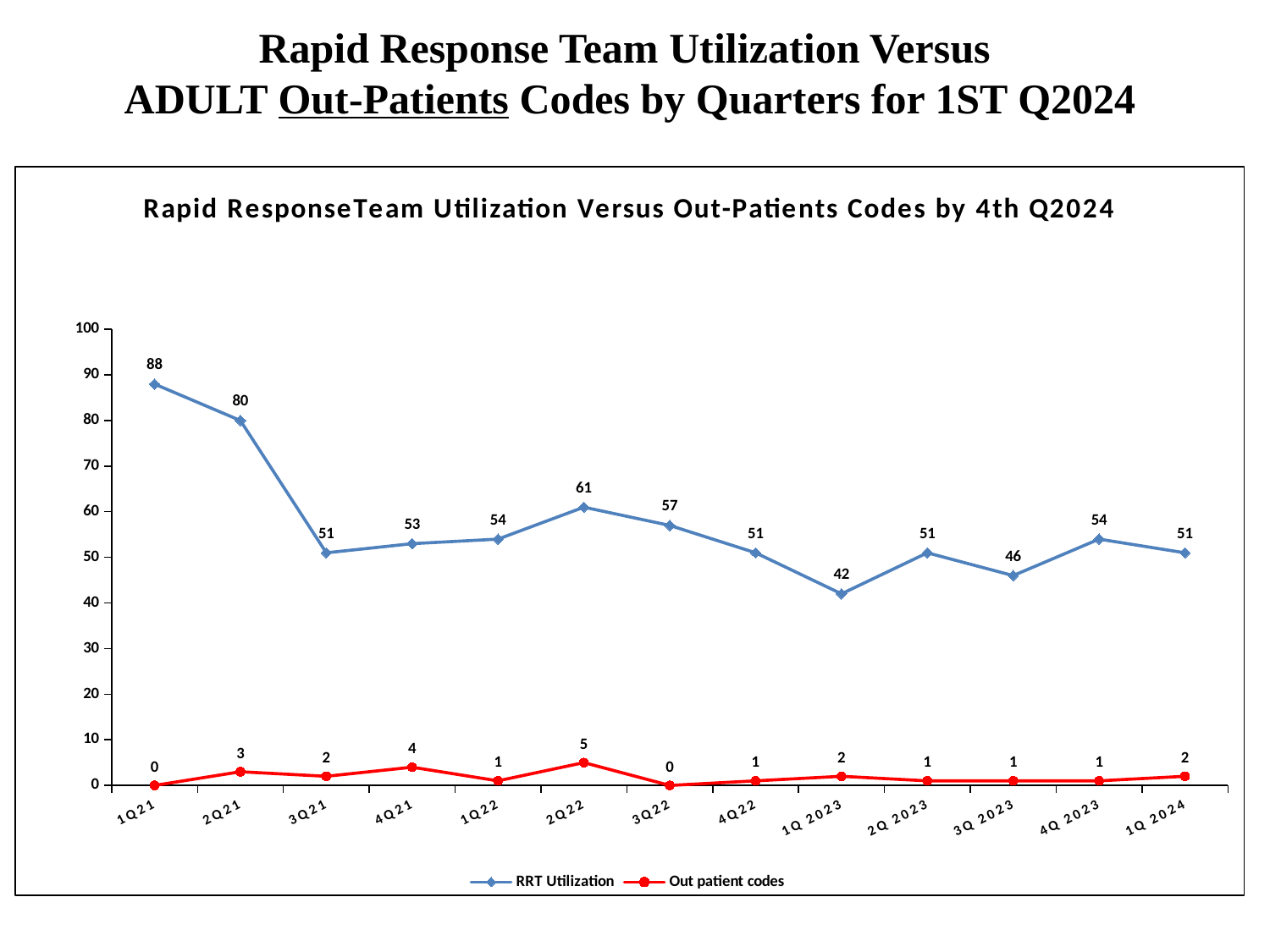
Which quarter has the highest RRT Utilization value? 1Q21 Does the RRT Utilization series rise or fall from 1Q21 to 3Q21? fall What is the difference between the RRT Utilization values for 1Q21 and 2Q21? 8 Which quarter has the lowest RRT Utilization value? 1Q 2023 How many series does the legend list? 2 What is the RRT Utilization value for 1Q 2024? 51 How many quarters are shown on the x axis? 13 Which is larger, the RRT Utilization value for 2Q22 or for 3Q22? 2Q22 Is the RRT Utilization value for 1Q 2023 greater or less than 50? less What kind of chart is shown on the slide? line chart What is the RRT Utilization value for 1Q21? 88 What is the Out patient codes value for 2Q22? 5